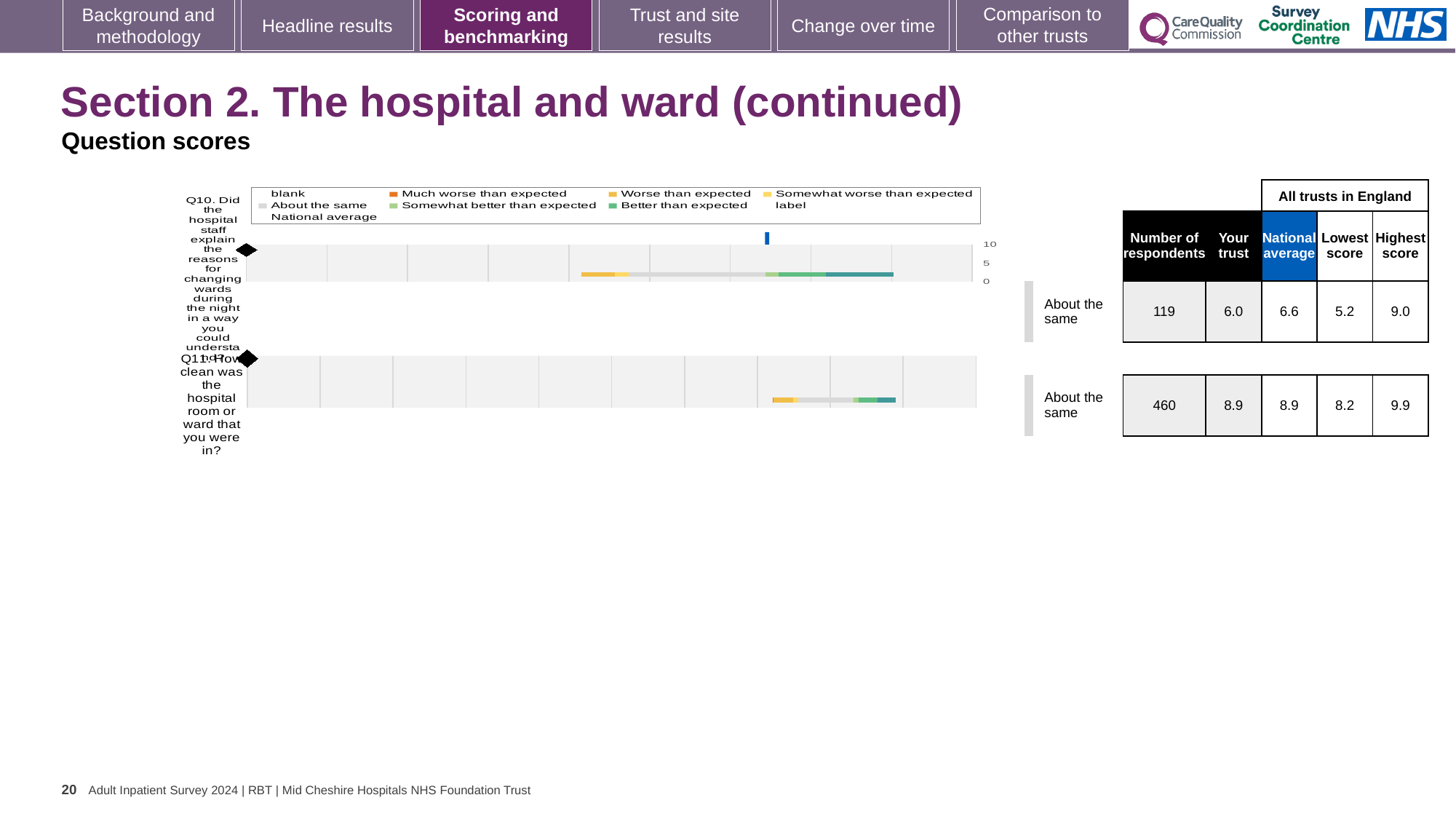
What is the maximum value shown on the axis of the Q10 chart? 10 In the table beside the Q10 chart, what is the national average for Q10? 6.6 In the table beside the Q10 chart, what is the 'Your trust' score for Q10? 6.0 How many question charts (Q10 and Q11) are shown on the slide? 2 What kind of chart is used for the Q10 and Q11 question scores on this slide? bar chart Which question has the higher 'Your trust' score in the tables beside the charts, Q10 or Q11? Q11 What is the difference between the highest score (9.0) and the lowest score (5.2) for Q10 in the table beside the chart? 3.8 In the table beside the Q11 chart, what is the 'Your trust' score for Q11? 8.9 In the table beside the Q11 chart, what is the highest score among all trusts in England for Q11? 9.9 How many respondents answered Q11, according to the table beside the Q11 chart? 460 What benchmark category label is shown next to the Q10 chart? About the same In the table beside the Q10 chart, what is the lowest score among all trusts in England for Q10? 5.2